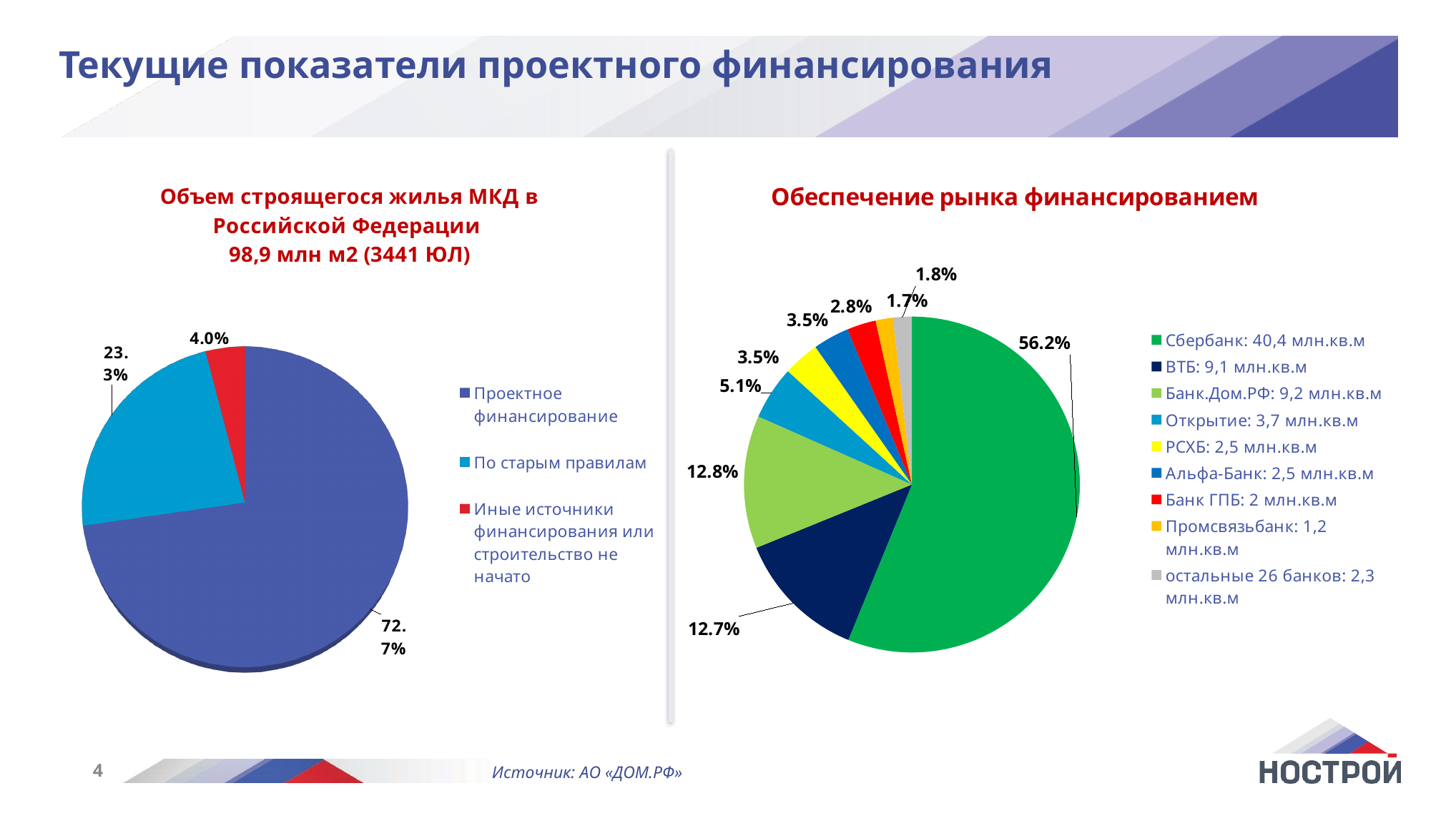
In the right chart, "Обеспечение рынка финансированием", how many entries does the legend list? 9 In the right chart, "Обеспечение рынка финансированием", what share is labelled for Сбербанк? 56.2% In the left chart, what share is labelled for "Проектное финансирование"? 72.7% In the left chart, which category has the smallest slice? Иные источники финансирования или строительство не начато In the right chart, "Обеспечение рынка финансированием", which is larger: the slice for Открытие or the slice for РСХБ? Открытие In the left chart, what share is labelled for "По старым правилам"? 23.3% In the left chart, how many slices does the pie have? 3 What kind of chart is the left chart, "Объем строящегося жилья МКД в Российской Федерации"? Pie chart In the left chart, what is the difference in percentage points between "Проектное финансирование" and "По старым правилам"? 49.4 In the right chart, "Обеспечение рынка финансированием", what volume does the legend give for ВТБ? 9,1 млн.кв.м In the right chart, "Обеспечение рынка финансированием", which bank has the largest slice? Сбербанк In the right chart, "Обеспечение рынка финансированием", what colour is the Сбербанк slice? Green